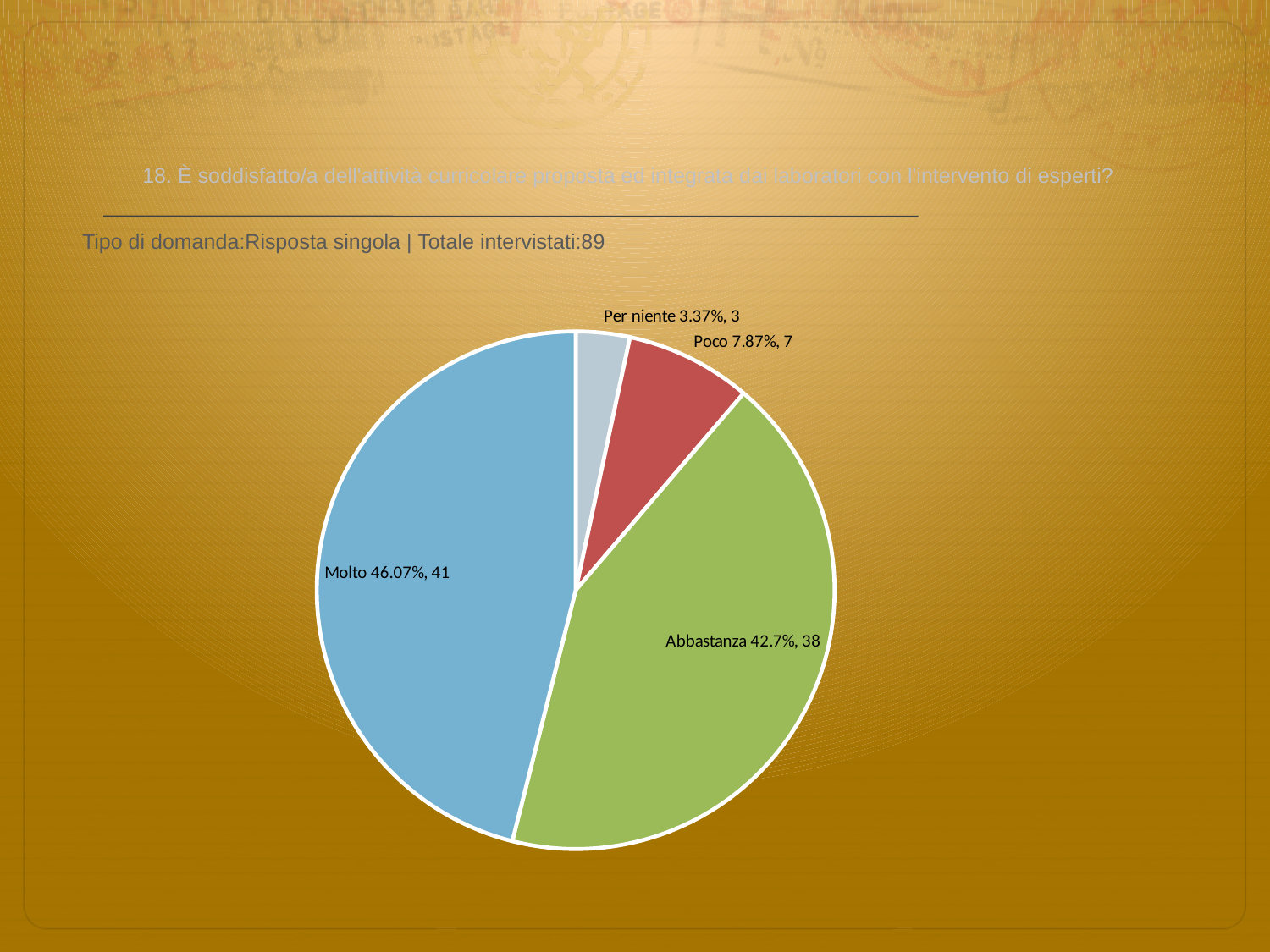
What is the difference in the number of respondents between "Molto" and "Abbastanza"? 3 What is the total number of respondents shown in the subtitle? 89 How many slices does the pie chart have? 4 Which response has the smallest share of the pie? Per niente What kind of chart is shown on the slide? pie chart Which response has the largest share of the pie? Molto What colour is the "Abbastanza" slice? green What percentage of respondents answered "Poco"? 7.87% How many respondents answered "Abbastanza"? 38 How many respondents answered "Per niente"? 3 Which has more respondents, "Poco" or "Per niente"? Poco What percentage of respondents answered "Molto"? 46.07%